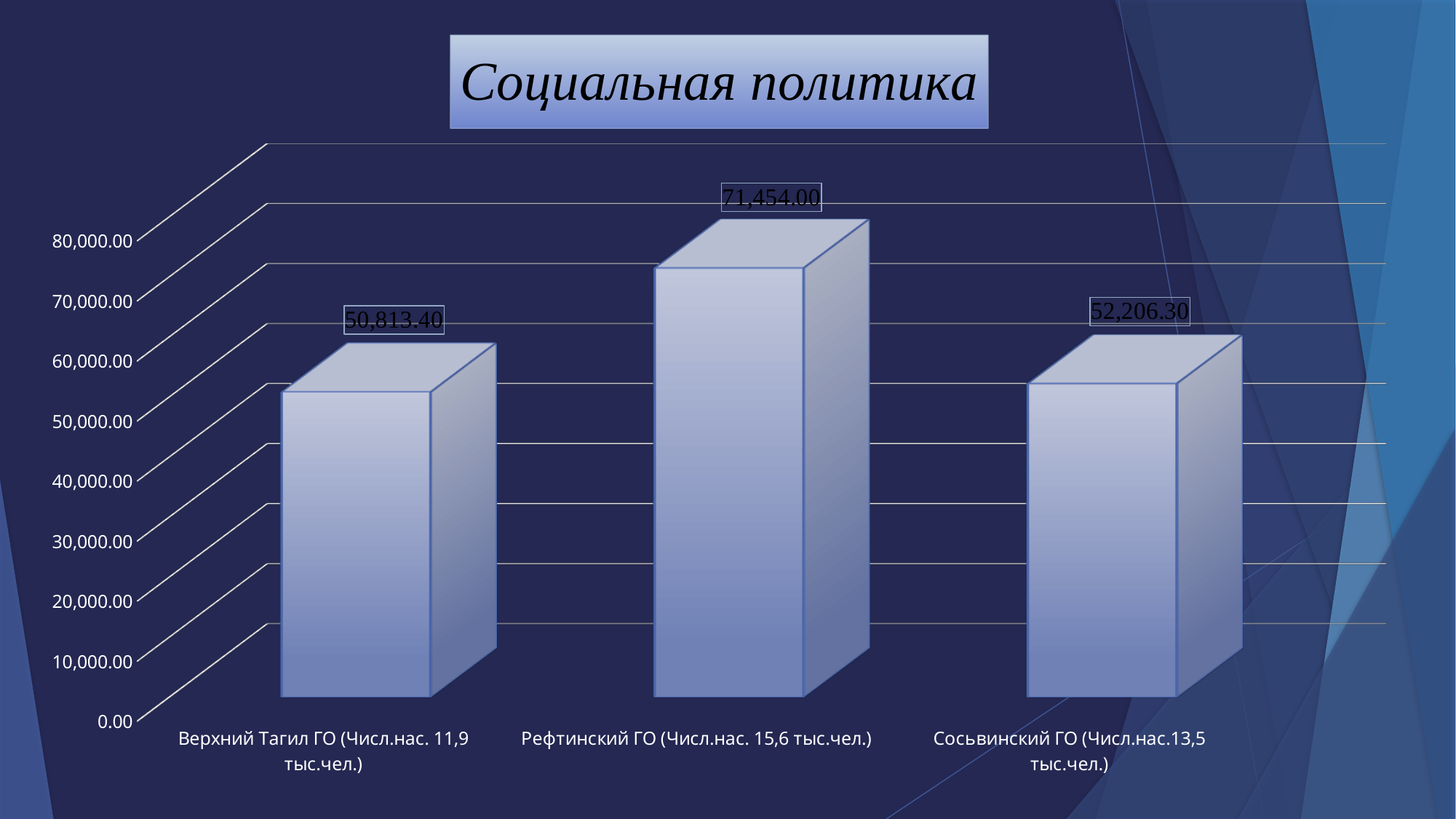
What is the value for Рефтинский ГО (Числ.нас. 15,6 тыс.чел.)? 71,454.00 What is the value for Верхний Тагил ГО (Числ.нас. 11,9 тыс.чел.)? 50,813.40 Which is larger, the value for Сосьвинский ГО or the value for Верхний Тагил ГО? Сосьвинский ГО What is the difference between the values for Рефтинский ГО and Сосьвинский ГО? 19,247.70 Which category has the highest value? Рефтинский ГО (Числ.нас. 15,6 тыс.чел.) What is the title shown above the chart? Социальная политика What is the difference between the values for Рефтинский ГО and Верхний Тагил ГО? 20,640.60 How many categories are shown in the chart? 3 Which category has the lowest value? Верхний Тагил ГО (Числ.нас. 11,9 тыс.чел.) Is the value for Верхний Тагил ГО greater or less than 60,000.00? less What kind of chart is shown on the slide? bar chart What is the value for Сосьвинский ГО (Числ.нас.13,5 тыс.чел.)? 52,206.30